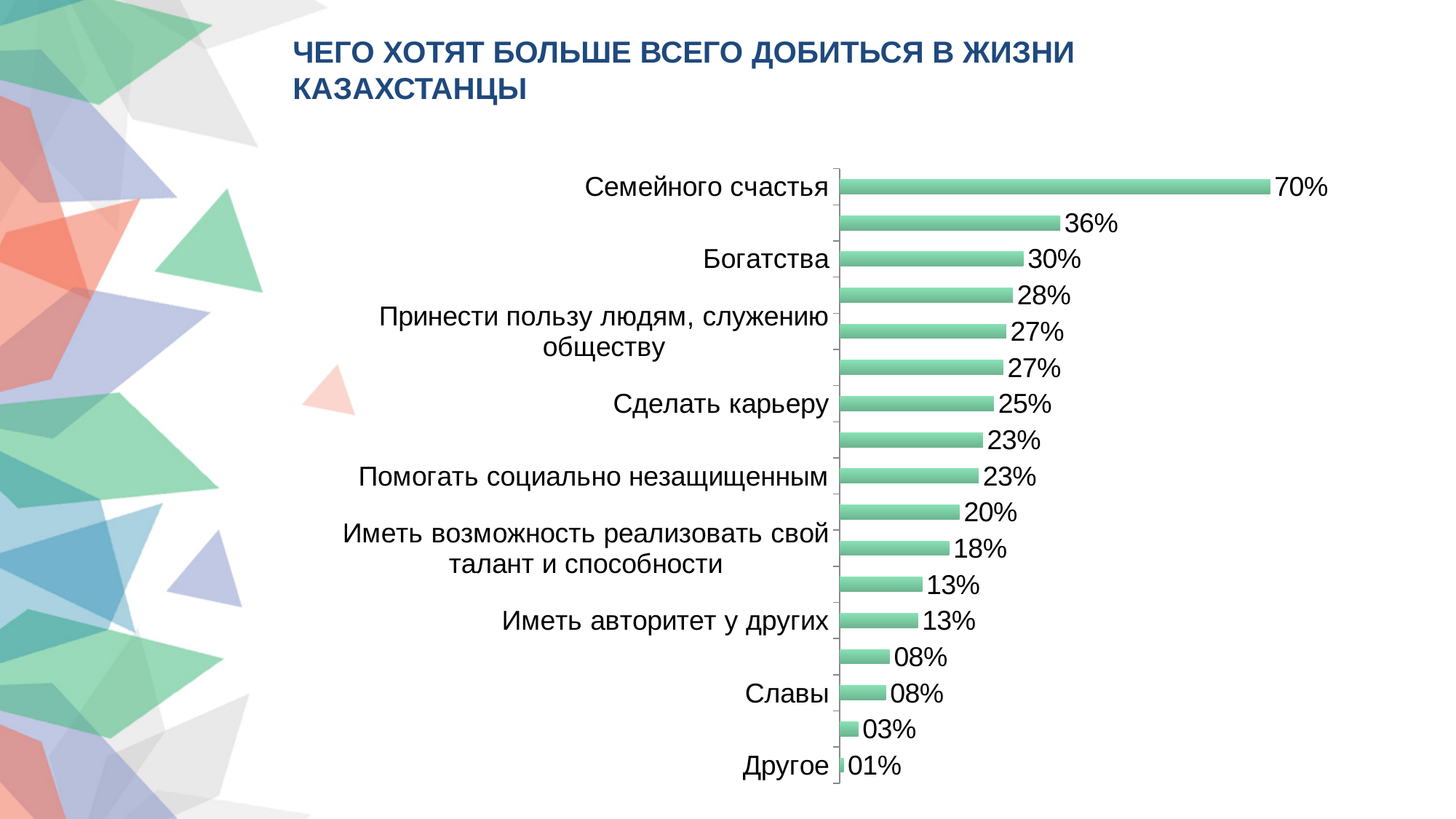
What is the difference between the values for "Семейного счастья" and "Богатства"? 40% How many bars are plotted in the chart? 17 What value is shown for "Другое"? 01% What kind of chart is shown on the slide? Bar chart What value is shown for "Сделать карьеру"? 25% What value is shown for "Славы"? 08% What value is shown for "Иметь авторитет у других"? 13% Which category has the lowest value? Другое Which is larger, the value for "Помогать социально незащищенным" or the value for "Иметь возможность реализовать свой талант и способности"? Помогать социально незащищенным Which category has the highest value? Семейного счастья What value is shown for "Богатства"? 30% What value is shown for "Семейного счастья"? 70%